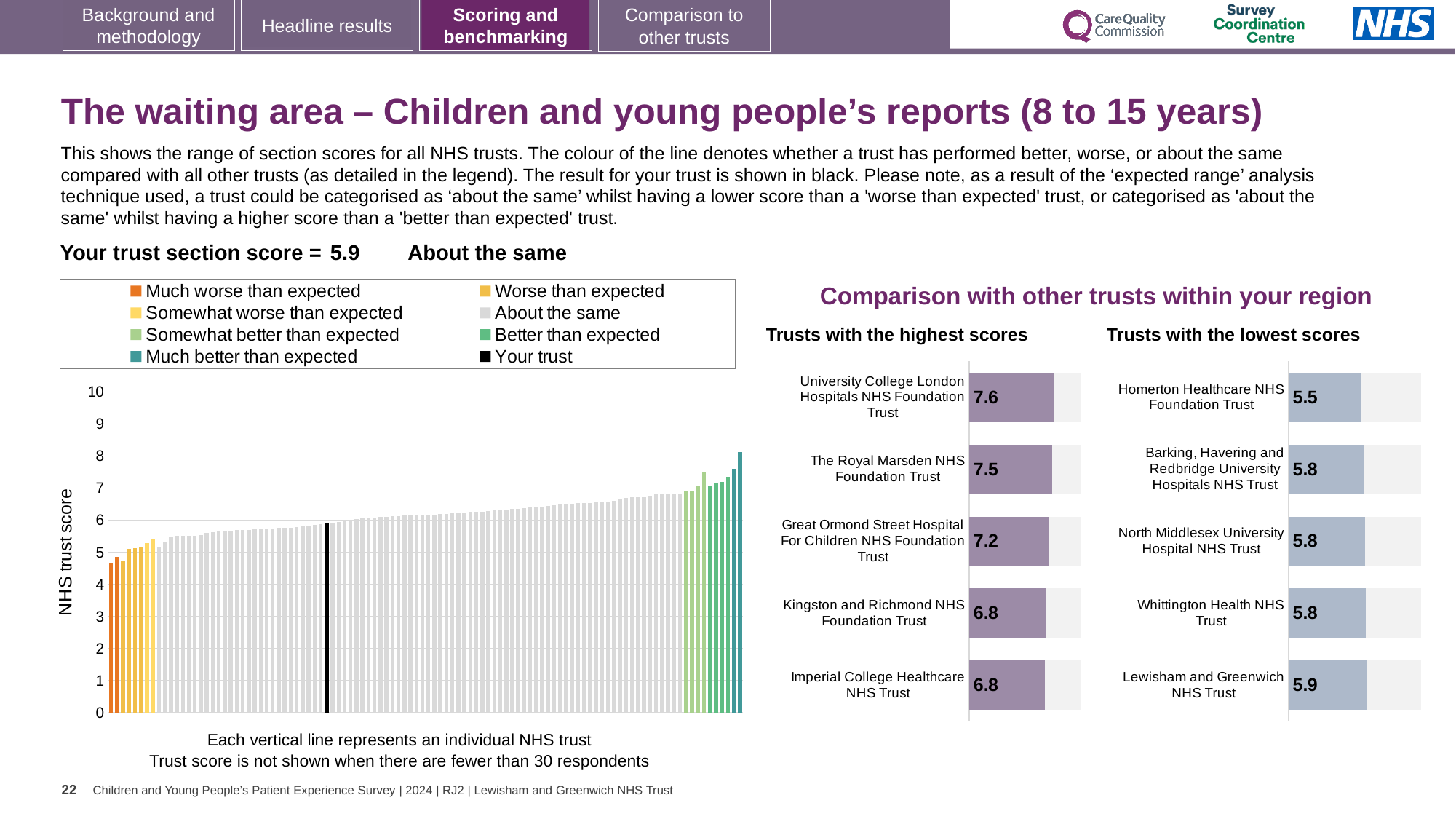
In the 'Trusts with the highest scores' chart, what is the score for University College London Hospitals NHS Foundation Trust? 7.6 In the NHS trust score chart on the left, do the bar values rise or fall from left to right? Rise How many trusts are listed in the 'Trusts with the lowest scores' chart? 5 What kind of chart is the NHS trust score chart on the left of the slide? Bar chart In the 'Trusts with the lowest scores' chart, which has the larger score: Lewisham and Greenwich NHS Trust or Homerton Healthcare NHS Foundation Trust? Lewisham and Greenwich NHS Trust In the 'Trusts with the highest scores' chart, what is the score for Great Ormond Street Hospital For Children NHS Foundation Trust? 7.2 In the 'Trusts with the lowest scores' chart, which trust has the lowest score? Homerton Healthcare NHS Foundation Trust In the 'Trusts with the lowest scores' chart, what is the score for Homerton Healthcare NHS Foundation Trust? 5.5 In the 'Trusts with the highest scores' chart, what is the difference between the scores of University College London Hospitals NHS Foundation Trust and Great Ormond Street Hospital For Children NHS Foundation Trust? 0.4 In the 'Trusts with the highest scores' chart, which trust has the highest score? University College London Hospitals NHS Foundation Trust In the NHS trust score chart on the left, how many entries does the legend list? 8 In the NHS trust score chart on the left, is the value of the lowest (leftmost) bar greater or less than 5? less